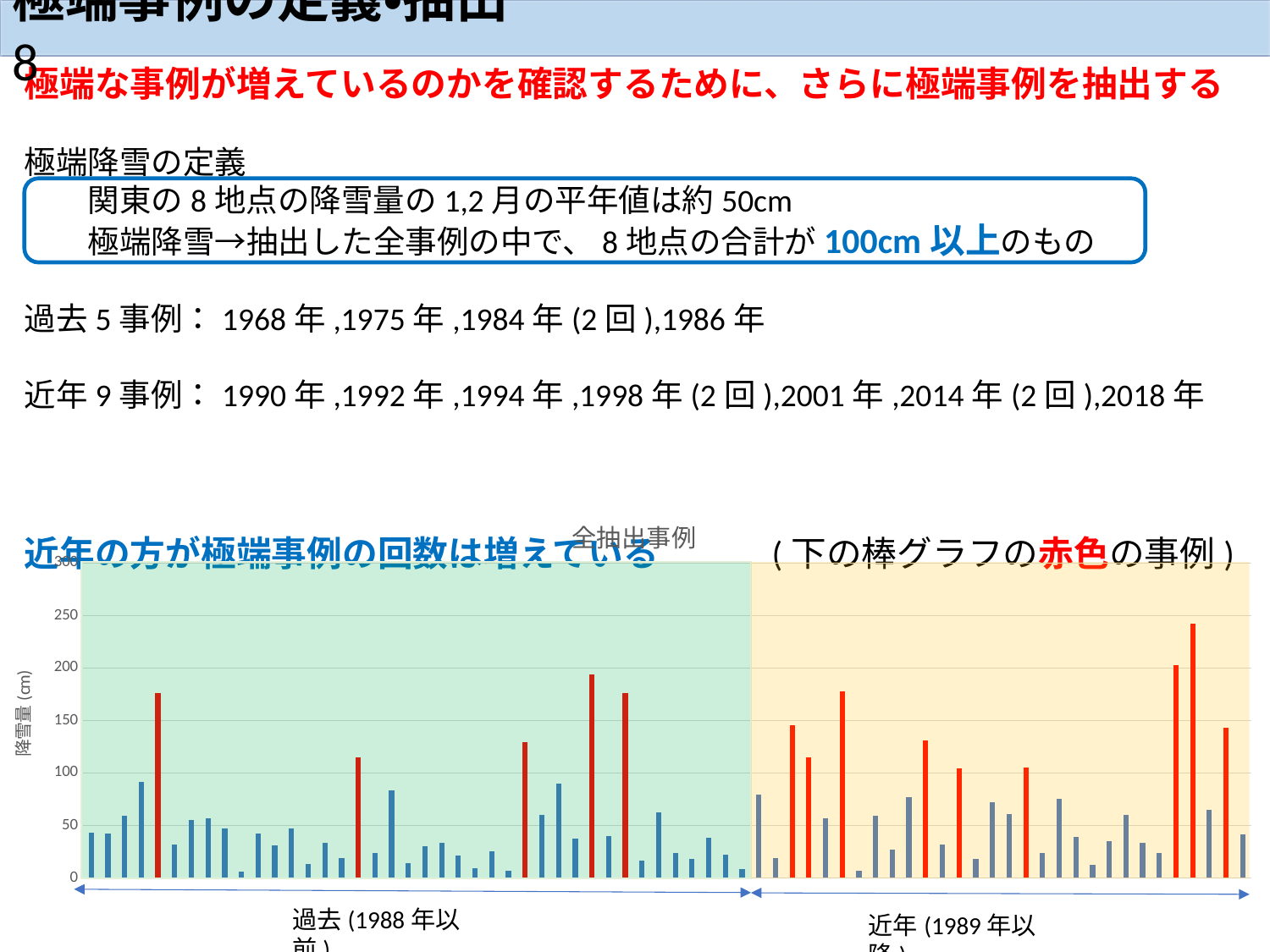
What is the title of the bar chart? 全抽出事例 In which section of the bar chart, 過去 or 近年, is the tallest bar overall located? 近年 What is the label on the vertical axis of the bar chart? 降雪量 (cm) Are all the red bars in the bar chart greater or less than 100? greater Is the tallest bar in the 過去 section of the bar chart greater or less than 150? greater Are all the blue bars in the bar chart greater or less than 100? less How many red bars are in the 過去 (1988年以前) section of the bar chart? 5 How many red bars are in the 近年 (1989年以降) section of the bar chart? 9 Which section of the bar chart, 過去 or 近年, contains more red bars? 近年 What is the highest value shown on the vertical axis of the bar chart? 300 What kind of chart is shown at the bottom of the slide? bar chart